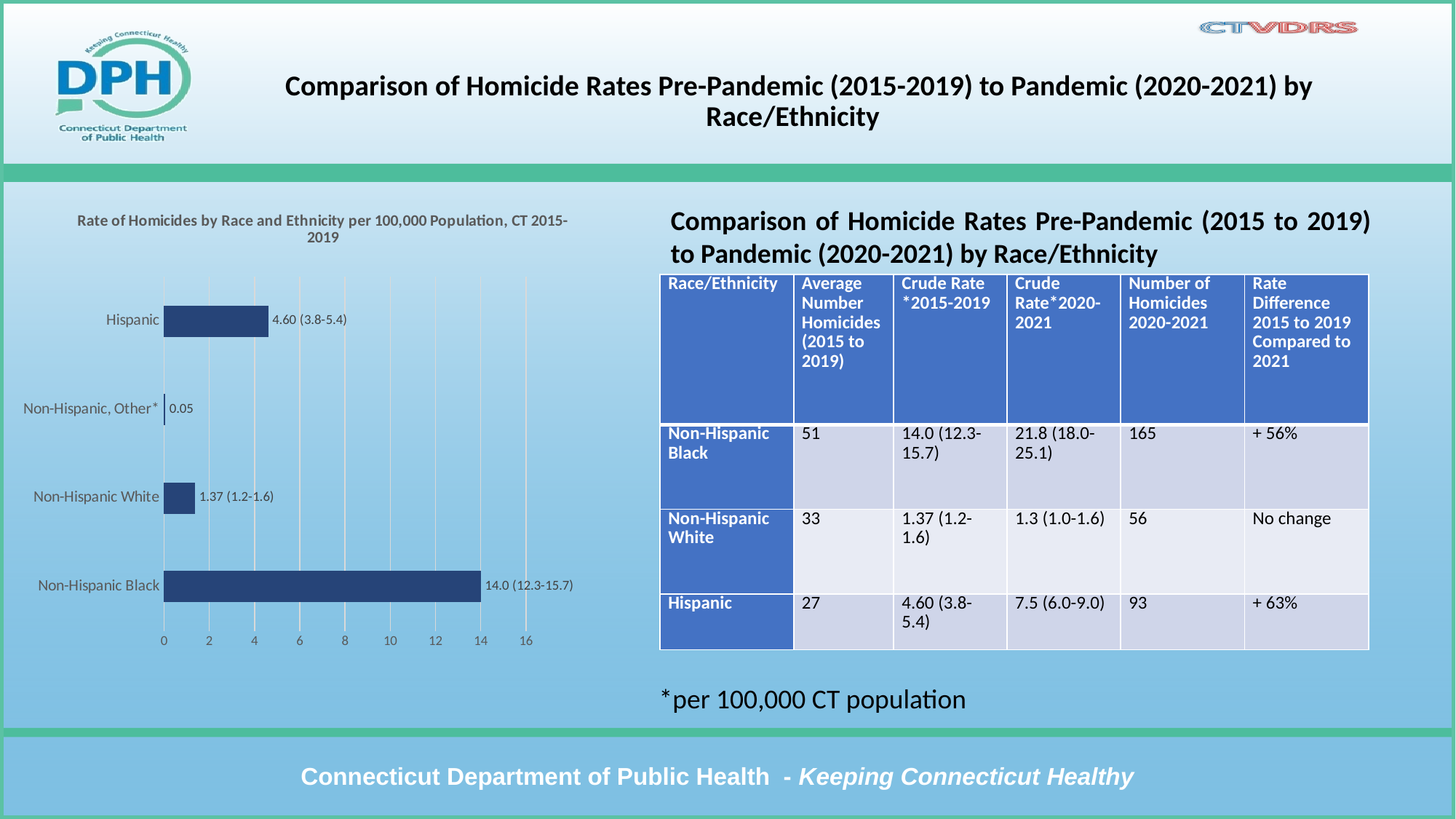
What is the homicide rate shown for Hispanic in the chart? 4.60 (3.8-5.4) What kind of chart is shown on the left of the slide? Bar chart How many race/ethnicity categories are plotted in the chart? 4 In the chart, which has a higher homicide rate, Hispanic or Non-Hispanic White? Hispanic Which category has the lowest homicide rate in the chart? Non-Hispanic, Other* What is the value shown for Non-Hispanic, Other* in the chart? 0.05 What is the maximum value shown on the x axis of the chart? 16 Is the homicide rate for Non-Hispanic Black in the chart greater or less than 12? greater What is the title of the chart on the slide? Rate of Homicides by Race and Ethnicity per 100,000 Population, CT 2015-2019 What is the homicide rate shown for Non-Hispanic Black in the chart? 14.0 (12.3-15.7) Which category has the highest homicide rate in the chart? Non-Hispanic Black What is the homicide rate shown for Non-Hispanic White in the chart? 1.37 (1.2-1.6)